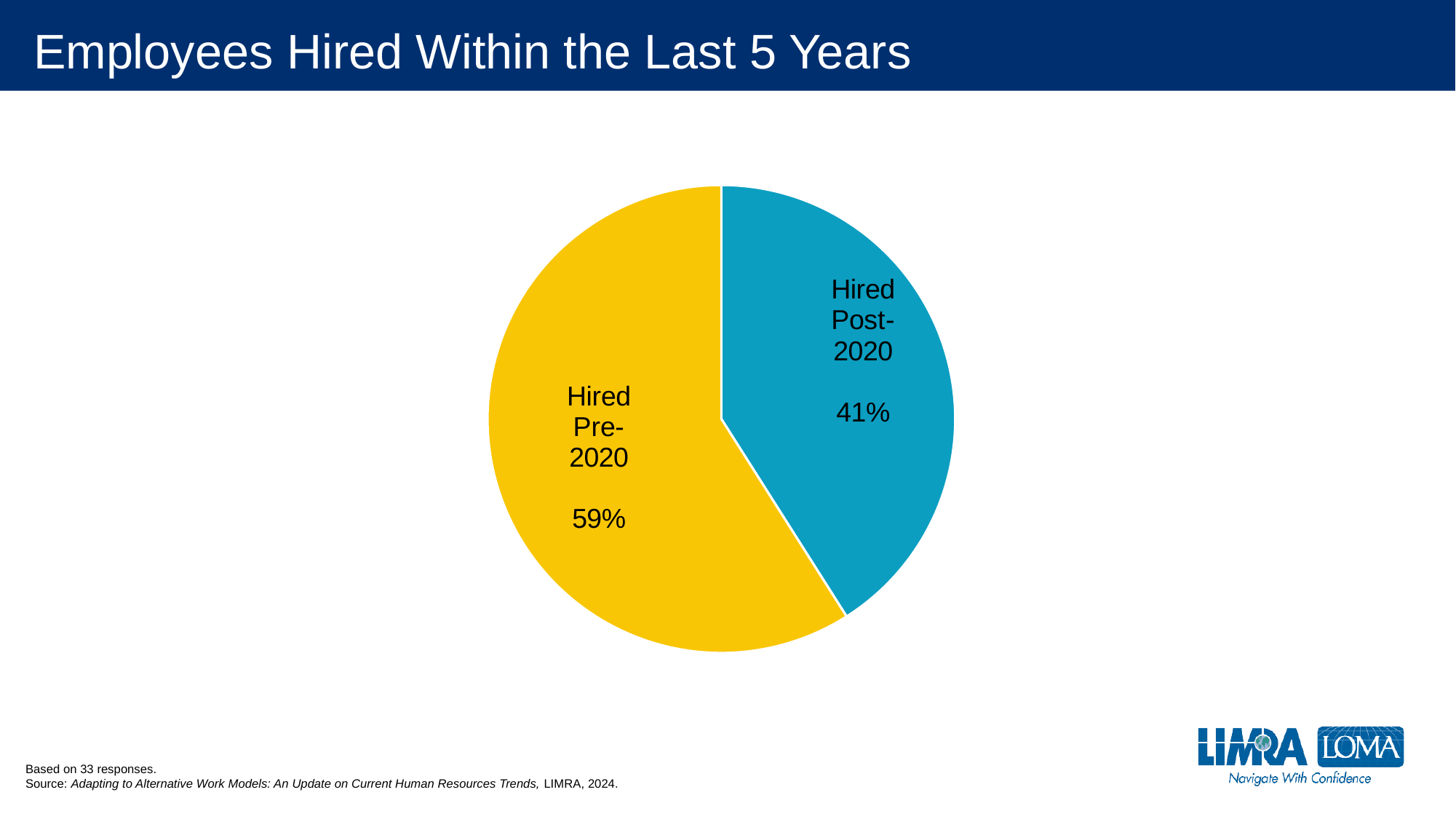
Is the share of employees hired post-2020 greater or less than 50%? less Which is larger: the share hired pre-2020 or the share hired post-2020? Hired Pre-2020 What is the title of the slide? Employees Hired Within the Last 5 Years What share of employees were hired pre-2020? 59% What kind of chart is shown on the slide? Pie chart What share of employees were hired post-2020? 41% Which slice of the pie is the largest? Hired Pre-2020 What is the difference in percentage points between the Hired Pre-2020 and Hired Post-2020 slices? 18 percentage points How many slices does the pie chart have? 2 What colour is the Hired Pre-2020 slice? Yellow Which slice of the pie is the smallest? Hired Post-2020 How many responses is the chart based on? 33